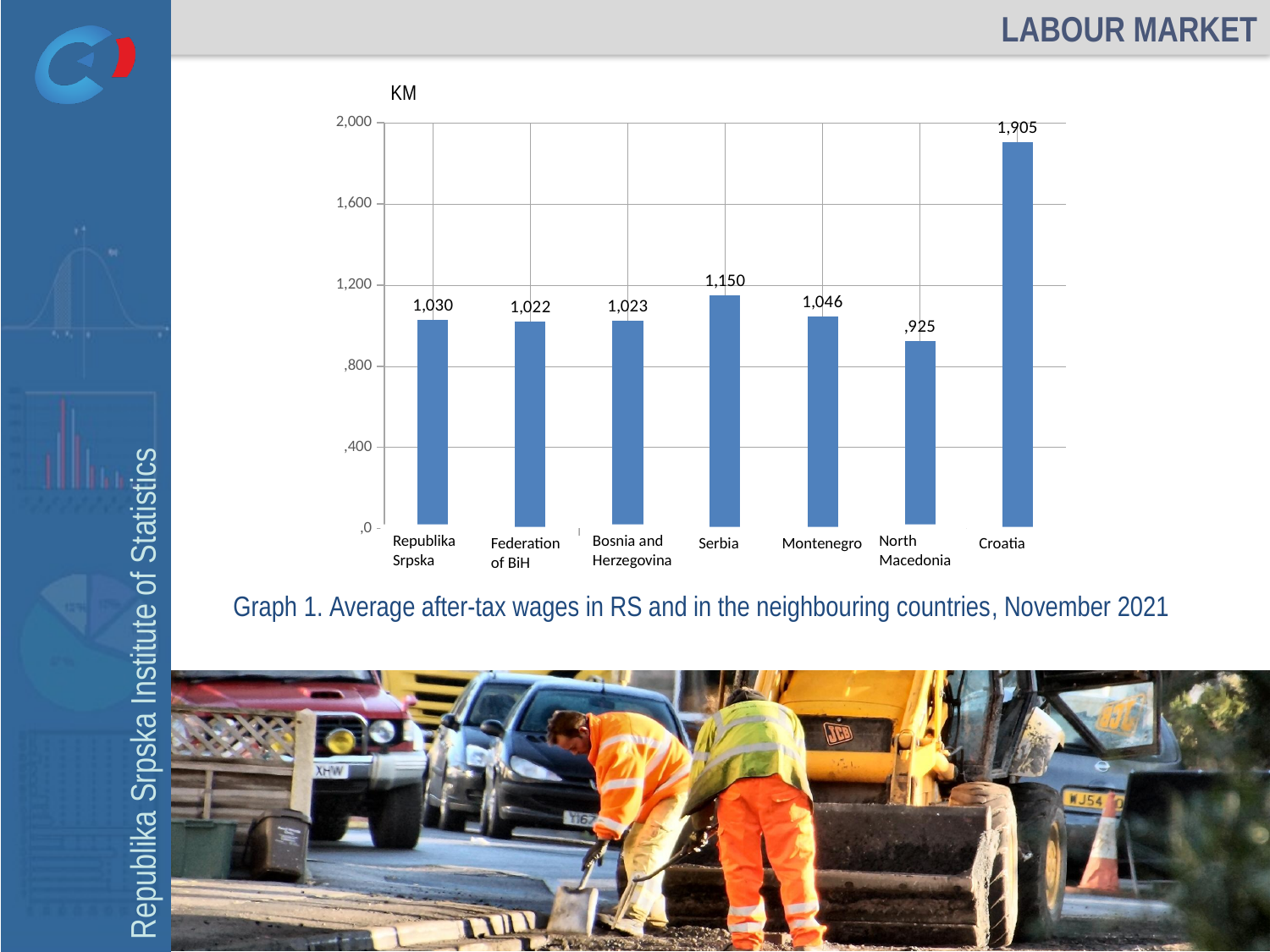
What type of chart is shown on the slide? Bar chart What is the value shown for Croatia? 1,905 How many countries or entities are shown in the chart? 7 Which has a higher value, Serbia or Montenegro? Serbia Is the value for Croatia greater or less than 1,600? greater Which country or entity has the highest average after-tax wage in the chart? Croatia What is the value shown for Serbia? 1,150 What is the value shown for Montenegro? 1,046 What is the average after-tax wage shown for Republika Srpska? 1,030 What is the difference between the values for Croatia and Serbia? 755 Which country or entity has the lowest average after-tax wage in the chart? North Macedonia What unit is shown at the top of the vertical axis? KM